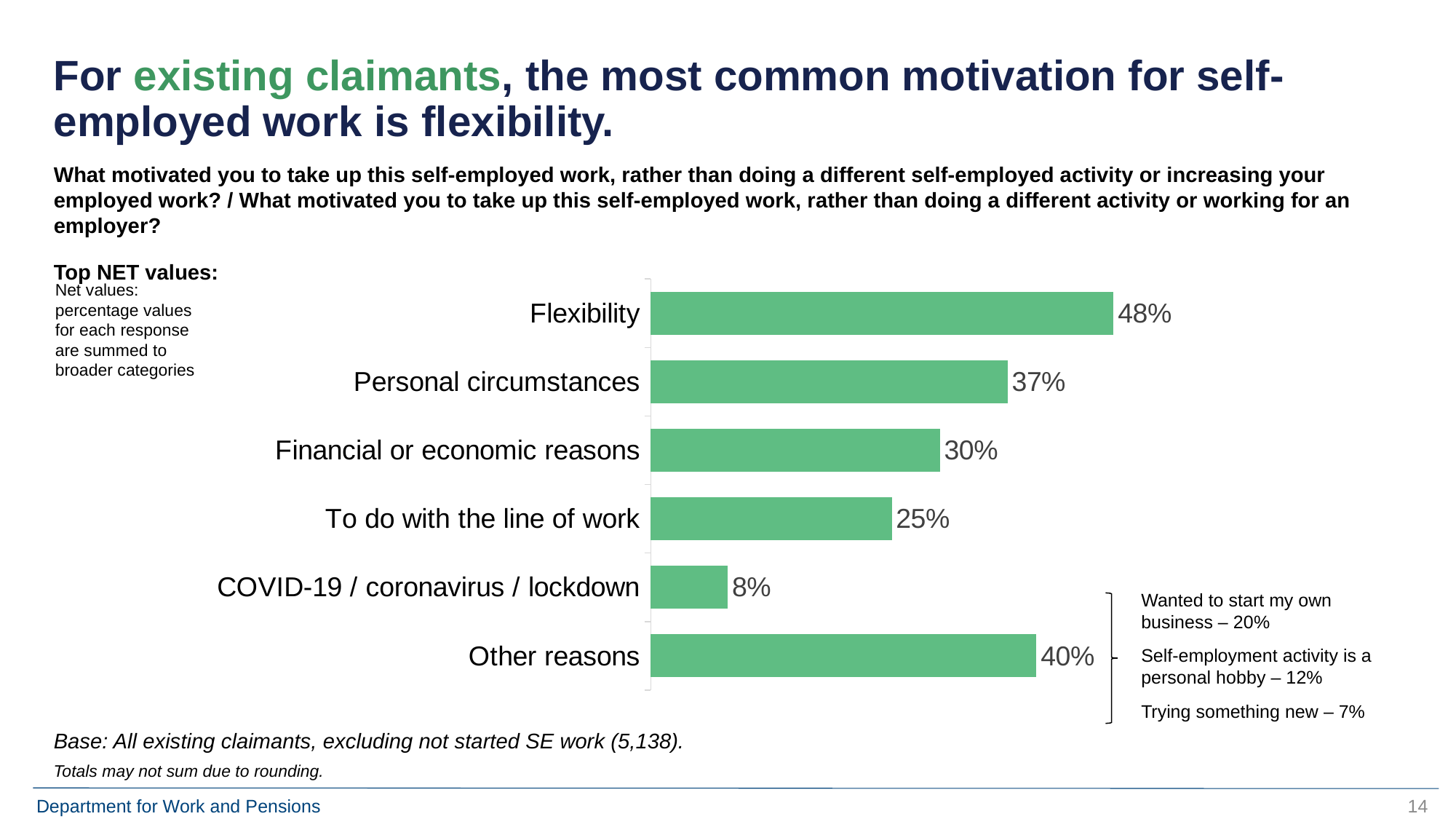
What kind of chart is shown on the slide? Bar chart According to the annotation next to the Other reasons bar, what percentage is given for 'Wanted to start my own business'? 20% What is the value for COVID-19 / coronavirus / lockdown? 8% What is the difference between the values for Flexibility and Personal circumstances? 11% What is the value for Personal circumstances? 37% What is the value for Flexibility? 48% Which category has the highest value? Flexibility How many categories are shown in the chart? 6 What is the value for Other reasons? 40% What is the difference between the values for Other reasons and COVID-19 / coronavirus / lockdown? 32% Which category has the lowest value? COVID-19 / coronavirus / lockdown Which is larger, the value for Financial or economic reasons or the value for To do with the line of work? Financial or economic reasons